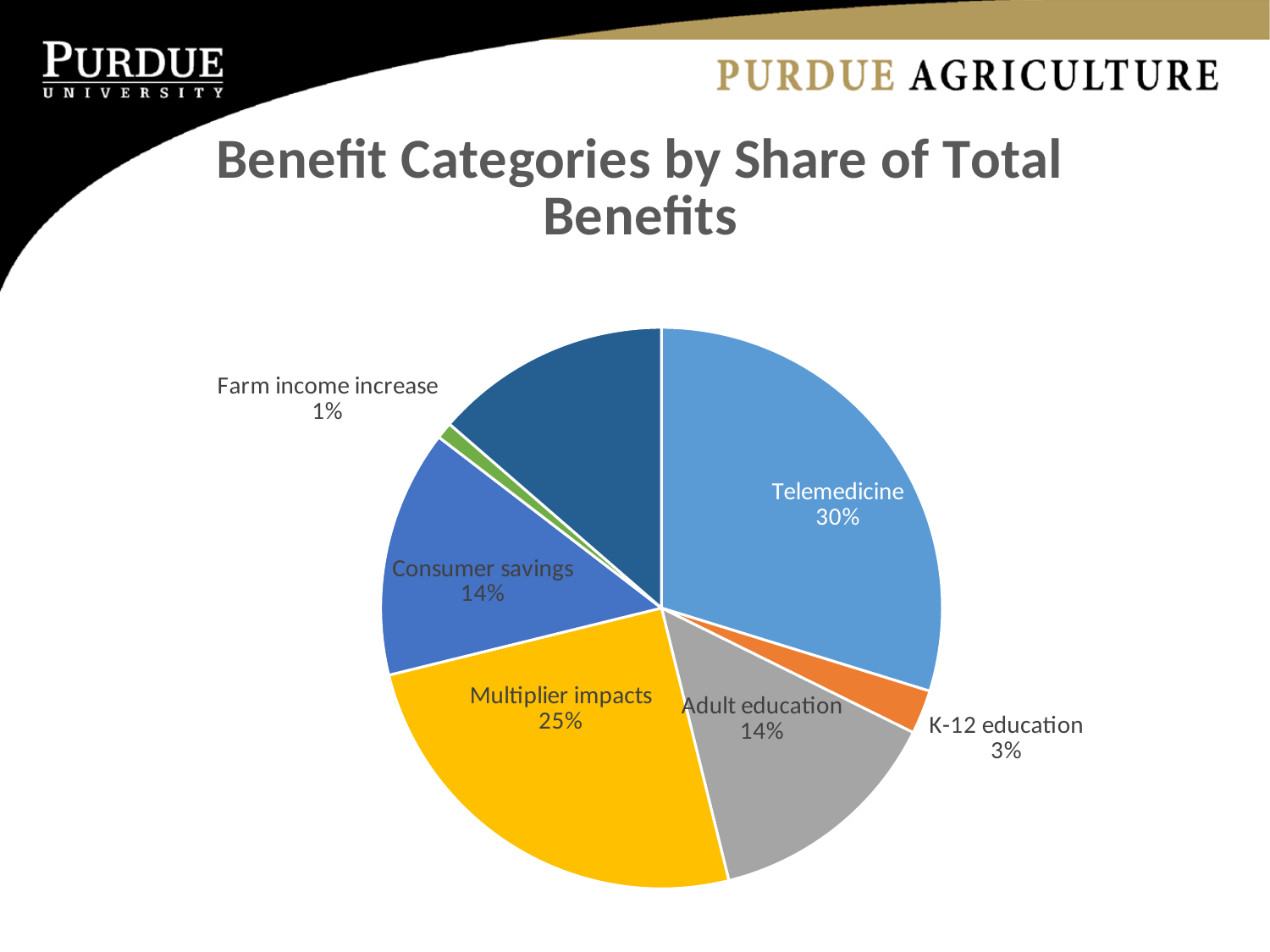
Which has a larger share of total benefits, Multiplier impacts or Adult education? Multiplier impacts Which benefit category has the smallest share of total benefits? Farm income increase How many percentage points larger is the Telemedicine share than the Multiplier impacts share? 5% What share of total benefits does Consumer savings account for? 14% What is the title of the chart? Benefit Categories by Share of Total Benefits What share of total benefits does Telemedicine account for? 30% How many slices does the pie chart have? 7 Which labeled benefit category has the largest share of total benefits? Telemedicine What share of total benefits is Farm income increase? 1% What kind of chart is shown on the slide? pie chart What share of total benefits is attributed to Multiplier impacts? 25% What share of total benefits does K-12 education represent? 3%